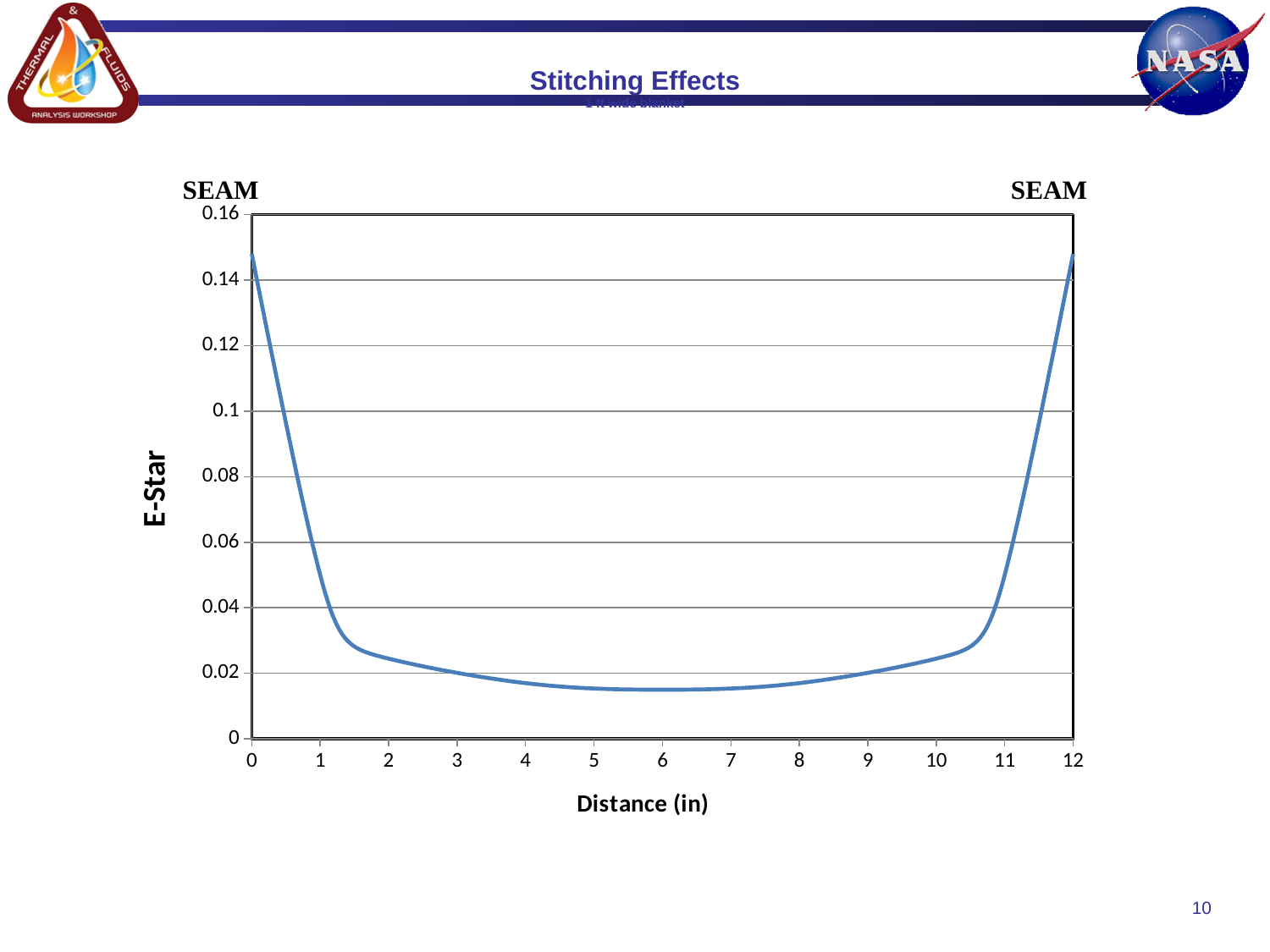
What kind of chart is shown on the slide? line chart Which has the larger E-Star value: a distance of 0 in or a distance of 6 in? 0 in Is the E-Star value at a distance of 12 in greater or less than 0.1? greater What is the label of the x axis of the chart? Distance (in) Is the E-Star value at a distance of 6 in greater or less than 0.02? less What is the label of the y axis of the chart? E-Star Is the E-Star value at a distance of 11 in greater or less than 0.08? less Does the E-Star value rise or fall as distance increases from 0 in to 6 in? fall Which has the larger E-Star value: a distance of 1 in or a distance of 2 in? 1 in Does the E-Star value rise or fall as distance increases from 6 in to 12 in? rise